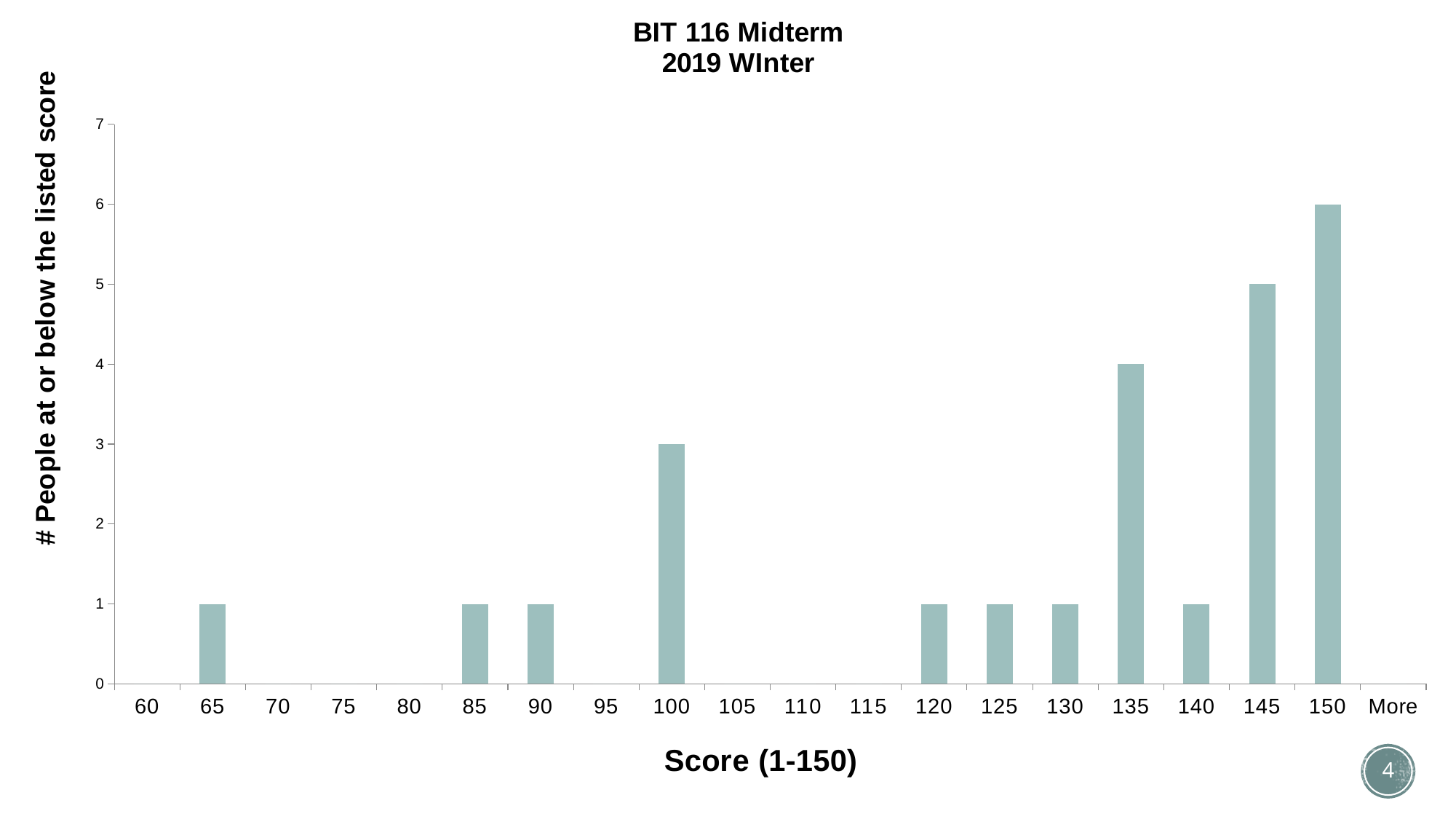
Which has a larger value, score 135 or score 100? 135 Is the value for score 150 greater or less than 5? greater What is the label of the x axis? Score (1-150) What is the value for the score 145? 5 What is the value for the score 100? 3 What is the difference between the values for scores 150 and 145? 1 What is the title of the chart? BIT 116 Midterm 2019 WInter How many categories are shown on the x axis? 20 What is the value for the score 135? 4 What is the value for the score 150? 6 What kind of chart is shown on the slide? bar chart Which score has the highest number of people? 150